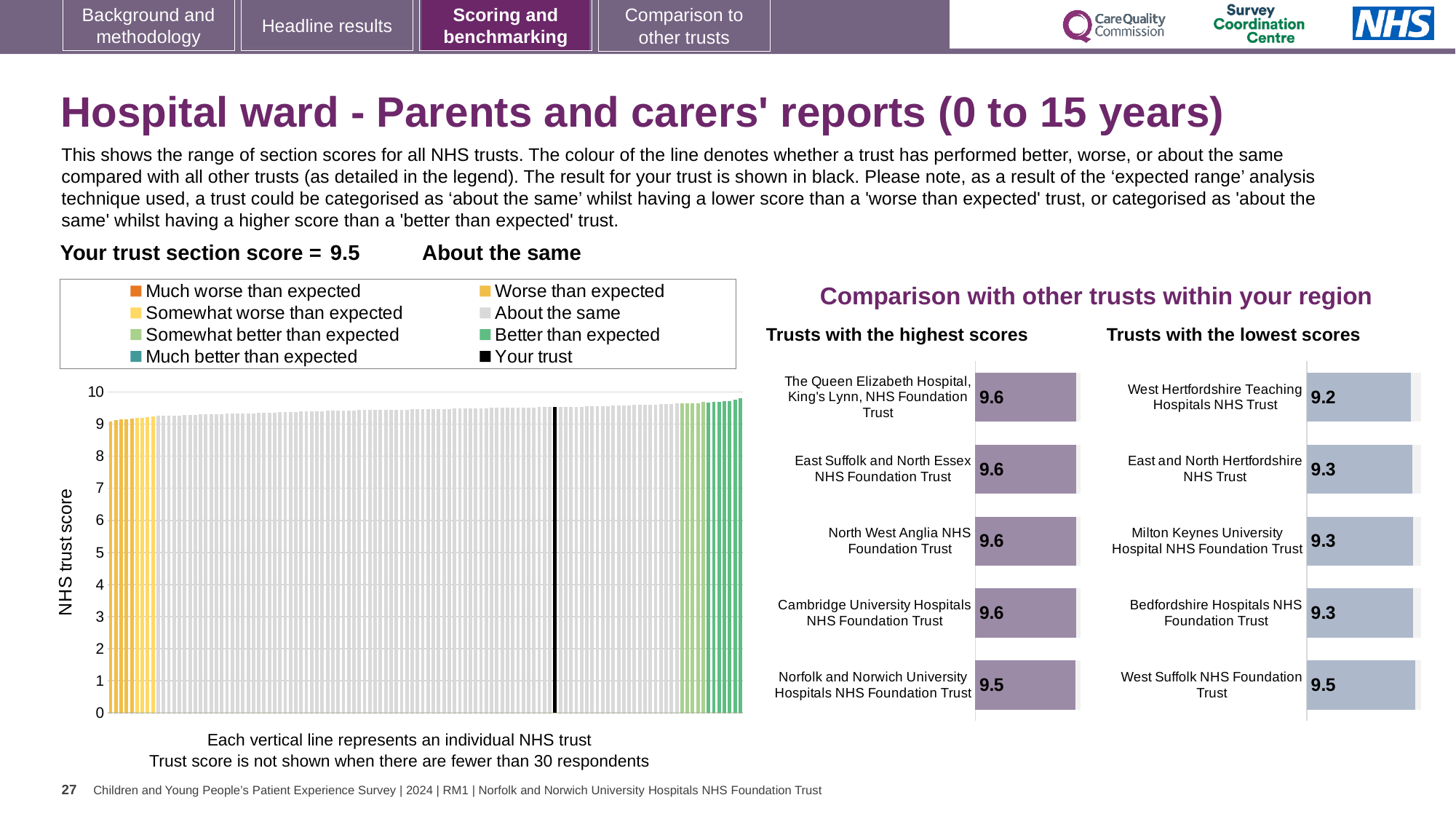
In the large chart on the left, is the value of the black 'Your trust' line greater or less than 8? greater In the 'Trusts with the highest scores' chart, which trust has the lowest score? Norfolk and Norwich University Hospitals NHS Foundation Trust In the 'Trusts with the highest scores' chart, what is the score for Norfolk and Norwich University Hospitals NHS Foundation Trust? 9.5 In the 'Trusts with the lowest scores' chart, what is the difference between the score for West Suffolk NHS Foundation Trust and the score for West Hertfordshire Teaching Hospitals NHS Trust? 0.3 In the 'Trusts with the lowest scores' chart, which trust has the lowest score? West Hertfordshire Teaching Hospitals NHS Trust In the 'Trusts with the lowest scores' chart, what is the score for West Hertfordshire Teaching Hospitals NHS Trust? 9.2 In the large chart on the left, how many entries does the legend list? 8 In the 'Trusts with the highest scores' chart, how many trusts are shown? 5 What is the y-axis label of the large chart on the left? NHS trust score What kind of chart is the large chart on the left with the y-axis labelled 'NHS trust score'? bar chart In the 'Trusts with the highest scores' chart, what is the difference between the score for The Queen Elizabeth Hospital, King's Lynn, NHS Foundation Trust and the score for Norfolk and Norwich University Hospitals NHS Foundation Trust? 0.1 In the 'Trusts with the lowest scores' chart, which trust has the highest score? West Suffolk NHS Foundation Trust